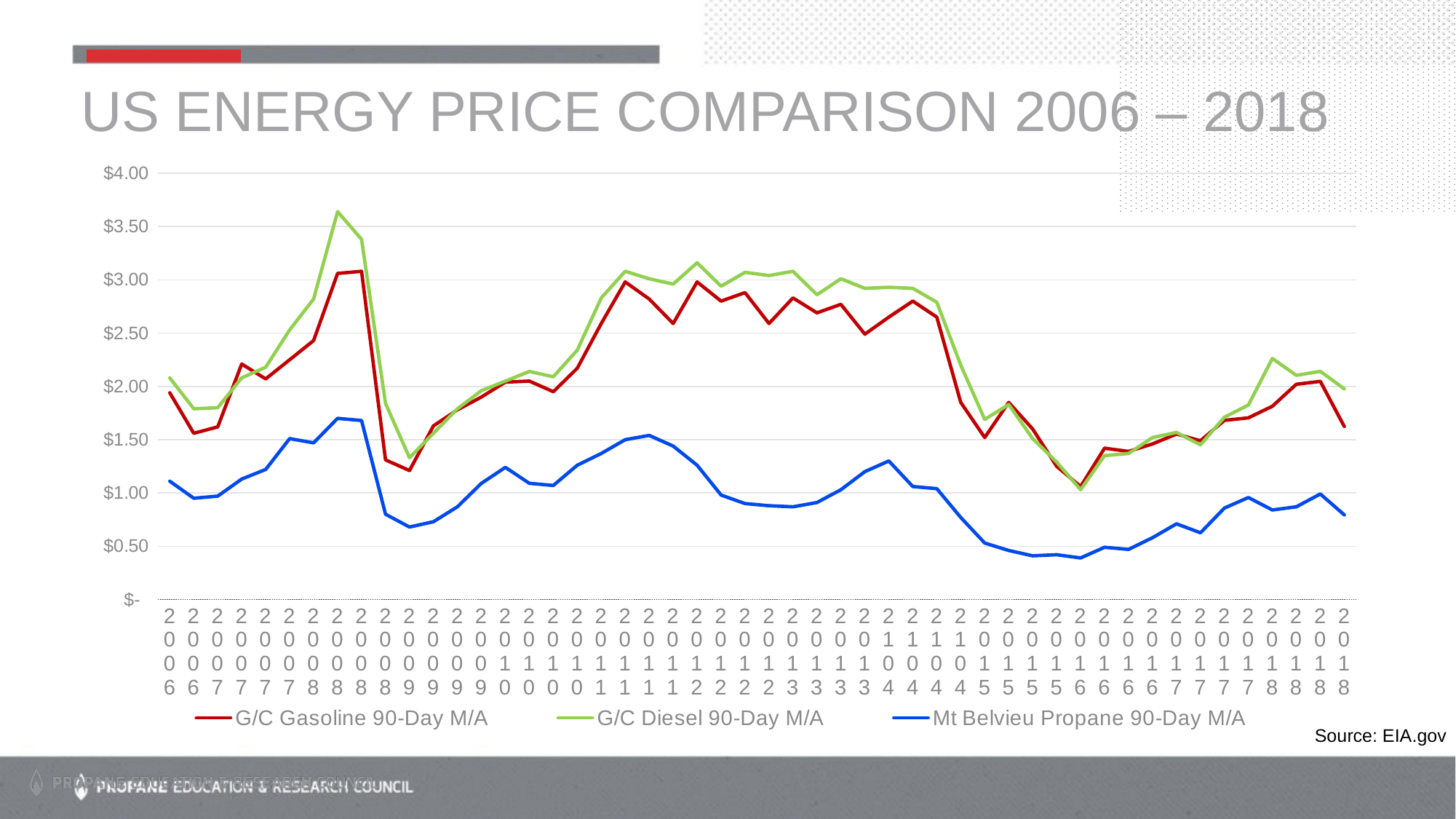
Does G/C Gasoline 90-Day M/A rise or fall from 2014 to 2016? Fall Which series reaches the highest value on the chart, at its 2008 peak? G/C Diesel 90-Day M/A What is the title of the chart? US ENERGY PRICE COMPARISON 2006 – 2018 How many series does the legend list? 3 In 2012, which is higher: G/C Diesel 90-Day M/A or Mt Belvieu Propane 90-Day M/A? G/C Diesel 90-Day M/A What kind of chart is shown on the slide? Line chart Is the lowest value of G/C Gasoline 90-Day M/A in 2016 greater or less than $1.50? less Is the peak value of Mt Belvieu Propane 90-Day M/A in 2008 greater or less than $1.50? greater Is the peak value of G/C Diesel 90-Day M/A in 2008 greater or less than $3.50? greater Which series is plotted with the blue line? Mt Belvieu Propane 90-Day M/A Which series has the lowest values across the whole period? Mt Belvieu Propane 90-Day M/A